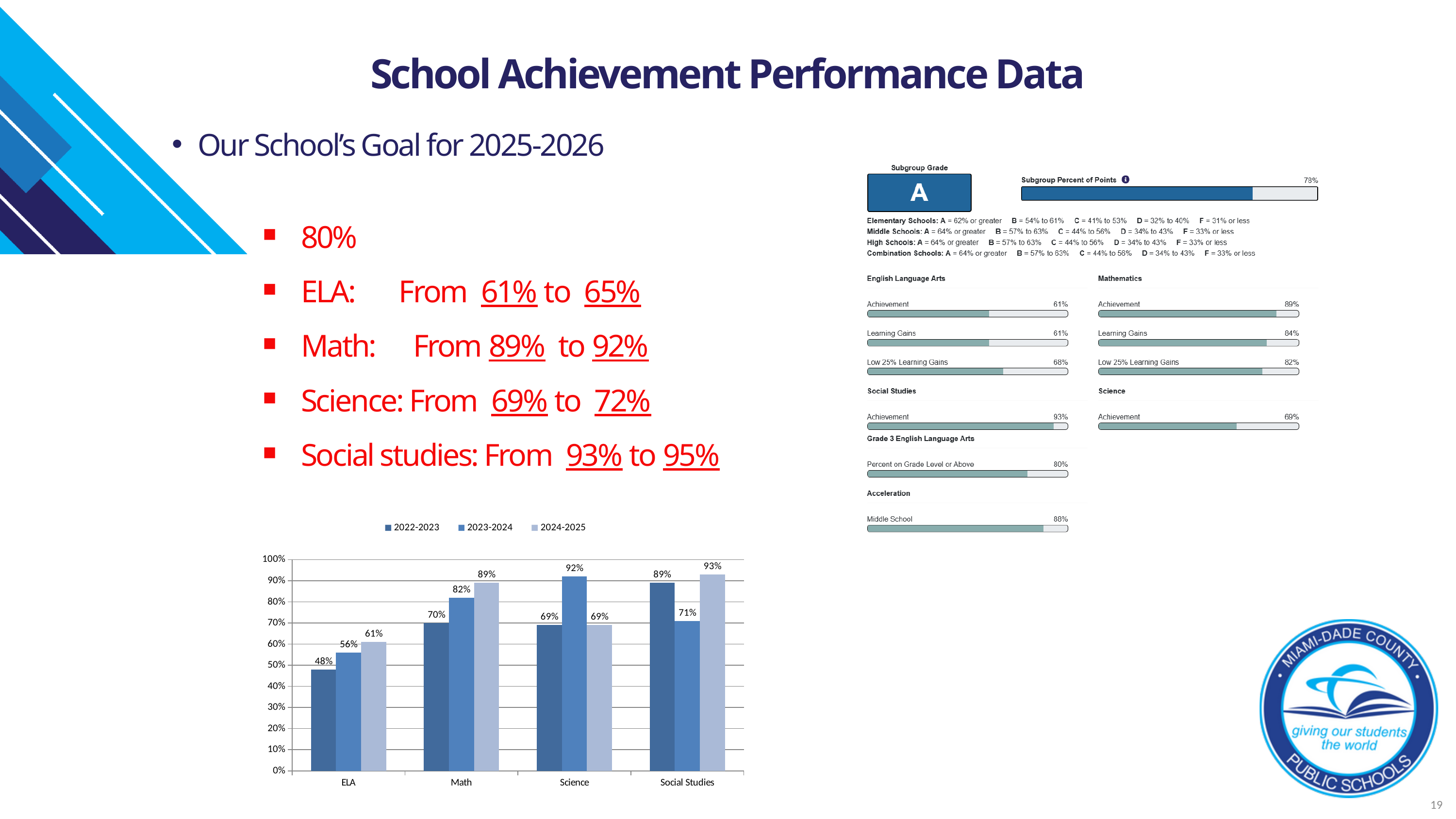
In the bar chart, what is the difference between the Math values for 2024-2025 and 2022-2023? 19% In the bar chart, what is the value for Science in 2023-2024? 92% In the bar chart, what is the value for ELA in 2024-2025? 61% In the bar chart, which subject has the highest value for 2024-2025? Social Studies What kind of chart is shown at the bottom left of the slide? Bar chart In the bar chart, what is the value for Math in 2022-2023? 70% How many subject categories are shown on the x axis of the bar chart? 4 In the bar chart, which is larger: the Science value for 2023-2024 or the Social Studies value for 2023-2024? Science 2023-2024 In the bar chart, do the ELA values rise or fall from 2022-2023 to 2024-2025? Rise In the bar chart, which subject has the lowest value for 2022-2023? ELA How many series does the legend of the bar chart list? 3 In the bar chart, what is the value for Social Studies in 2023-2024? 71%